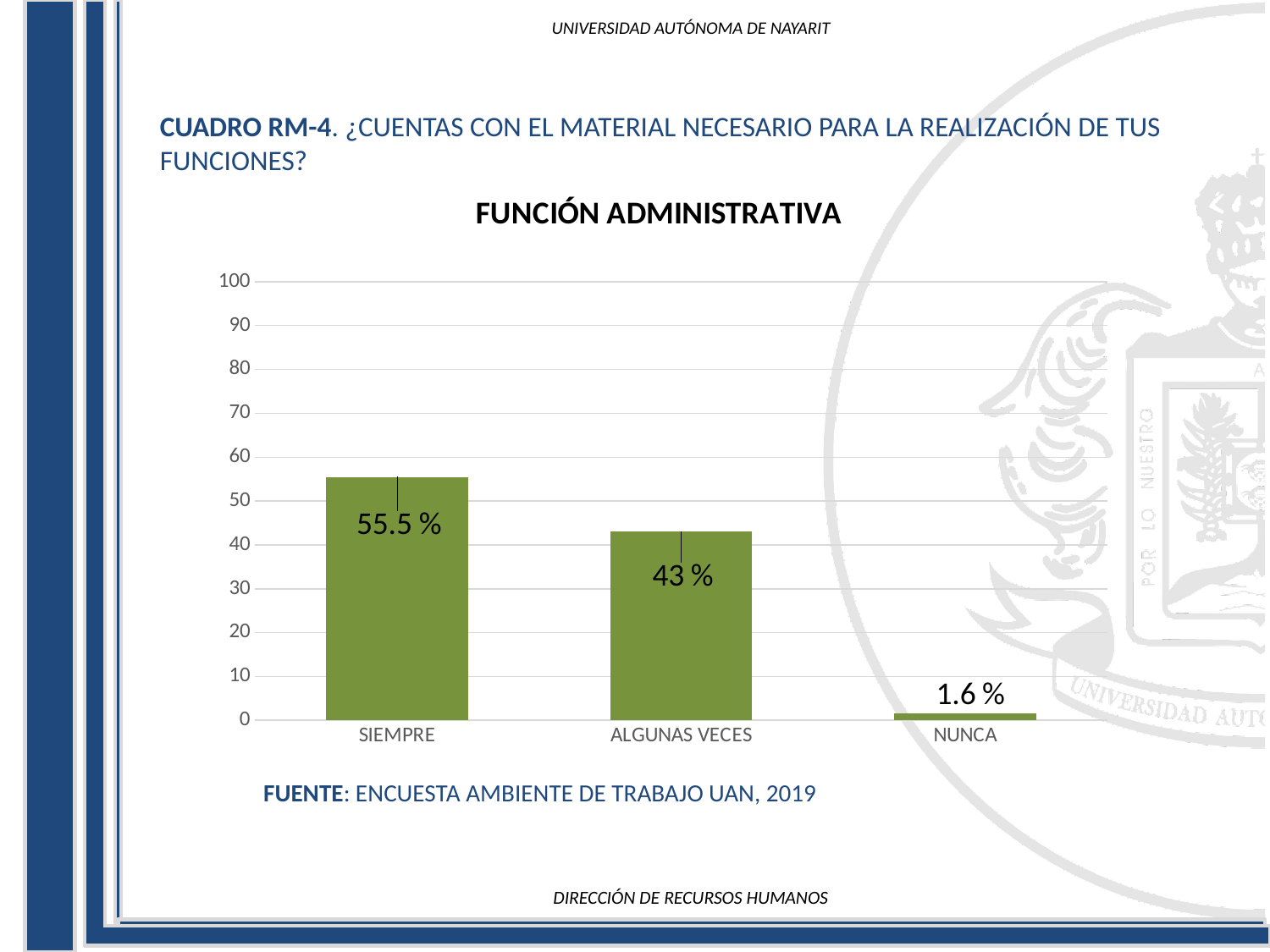
What is the difference between the values for ALGUNAS VECES and NUNCA? 41.4 % What is the title of the chart? FUNCIÓN ADMINISTRATIVA What is the value for ALGUNAS VECES? 43 % Which is larger, the value for SIEMPRE or the value for ALGUNAS VECES? SIEMPRE Which category has the lowest value? NUNCA What kind of chart is shown on the slide? bar chart What is the difference between the values for SIEMPRE and ALGUNAS VECES? 12.5 % How many categories are shown on the x axis? 3 Which category has the highest value? SIEMPRE What is the value for SIEMPRE? 55.5 % Is the value for ALGUNAS VECES greater or less than 50? less What is the value for NUNCA? 1.6 %